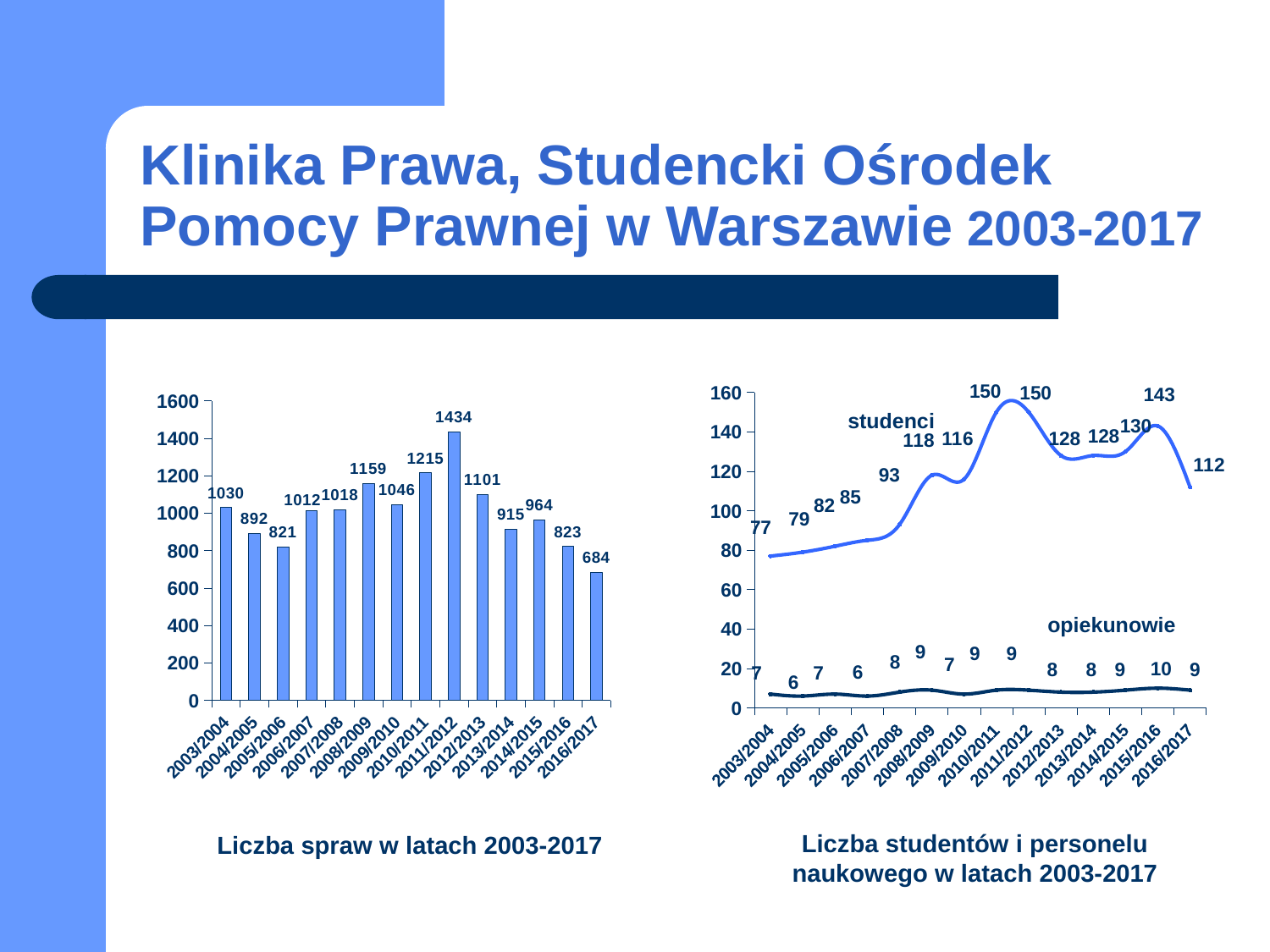
How many years are shown on the x axis of the chart 'Liczba spraw w latach 2003-2017'? 14 In the chart 'Liczba studentów i personelu naukowego w latach 2003-2017', what is the value for studenci in 2015/2016? 143 How many series are plotted in the chart 'Liczba studentów i personelu naukowego w latach 2003-2017'? 2 In the chart 'Liczba spraw w latach 2003-2017', what is the value for 2011/2012? 1434 What kind of chart is 'Liczba spraw w latach 2003-2017'? bar chart In the chart 'Liczba spraw w latach 2003-2017', which is larger: the value for 2008/2009 or the value for 2009/2010? 2008/2009 In the chart 'Liczba spraw w latach 2003-2017', which year has the highest value? 2011/2012 In the chart 'Liczba spraw w latach 2003-2017', what is the difference between the values for 2011/2012 and 2016/2017? 750 What kind of chart is 'Liczba studentów i personelu naukowego w latach 2003-2017'? line chart In the chart 'Liczba studentów i personelu naukowego w latach 2003-2017', what is the difference between studenci and opiekunowie in 2003/2004? 70 In the chart 'Liczba spraw w latach 2003-2017', which year has the lowest value? 2016/2017 In the chart 'Liczba studentów i personelu naukowego w latach 2003-2017', what is the value for opiekunowie in 2015/2016? 10